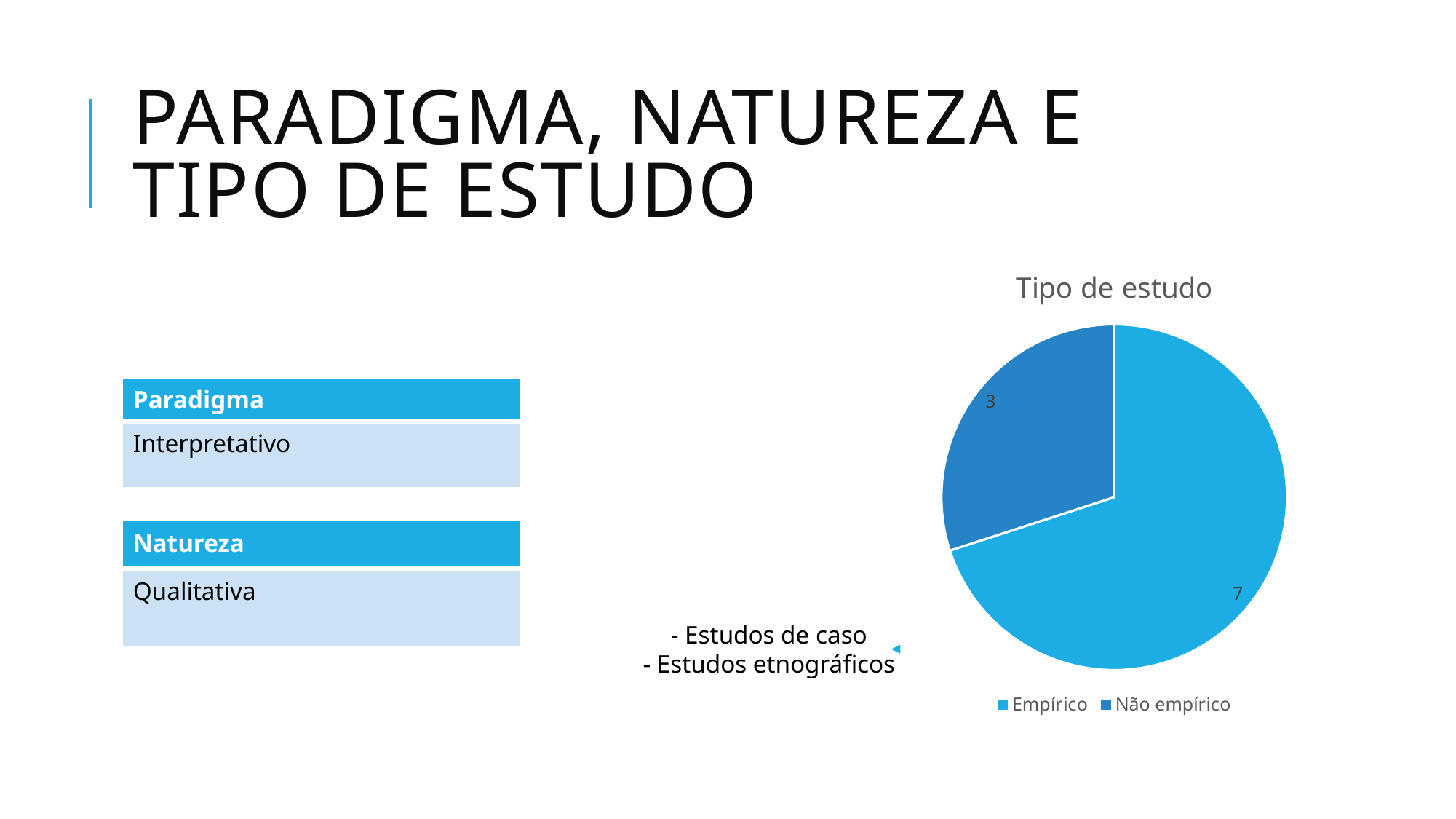
What is the value for Empírico in the pie chart? 7 What kind of chart is shown on the slide? pie chart Which is larger, the value for Empírico or the value for Não empírico? Empírico How many categories does the pie chart have? 2 What share of the pie does Não empírico represent? 30% What is the total of all slices in the pie chart? 10 Which category has the smallest slice in the pie chart? Não empírico What is the value for Não empírico in the pie chart? 3 What is the difference between the values for Empírico and Não empírico? 4 What is the title of the chart? Tipo de estudo Which category has the largest slice in the pie chart? Empírico What share of the pie does Empírico represent? 70%